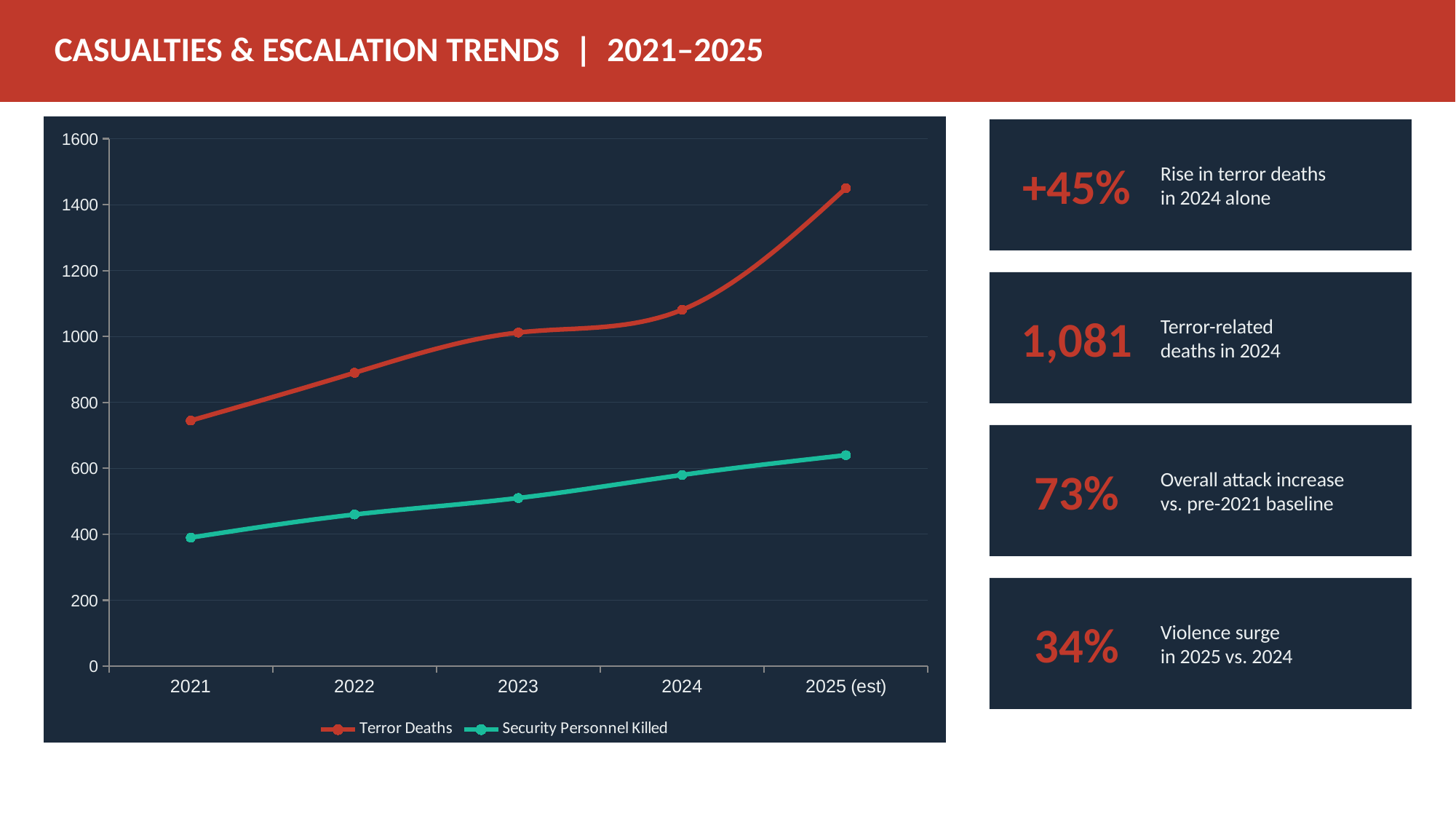
Is the Terror Deaths value for 2025 (est) greater or less than 1400? greater Do the Security Personnel Killed values rise or fall across the years shown? rise In 2024, which series has the larger value: Terror Deaths or Security Personnel Killed? Terror Deaths How many years are plotted along the x axis of the chart? 5 Is the Security Personnel Killed value for 2025 (est) greater or less than 600? greater In which year does the Terror Deaths series reach its highest value? 2025 (est) Is the Terror Deaths value for 2021 greater or less than 800? less What kind of chart is shown on the slide? line chart How many series does the chart legend list? 2 In which year is the Security Personnel Killed series at its lowest? 2021 What colour is the Terror Deaths line in the chart? red Do the Terror Deaths values rise or fall from 2021 to 2025 (est)? rise